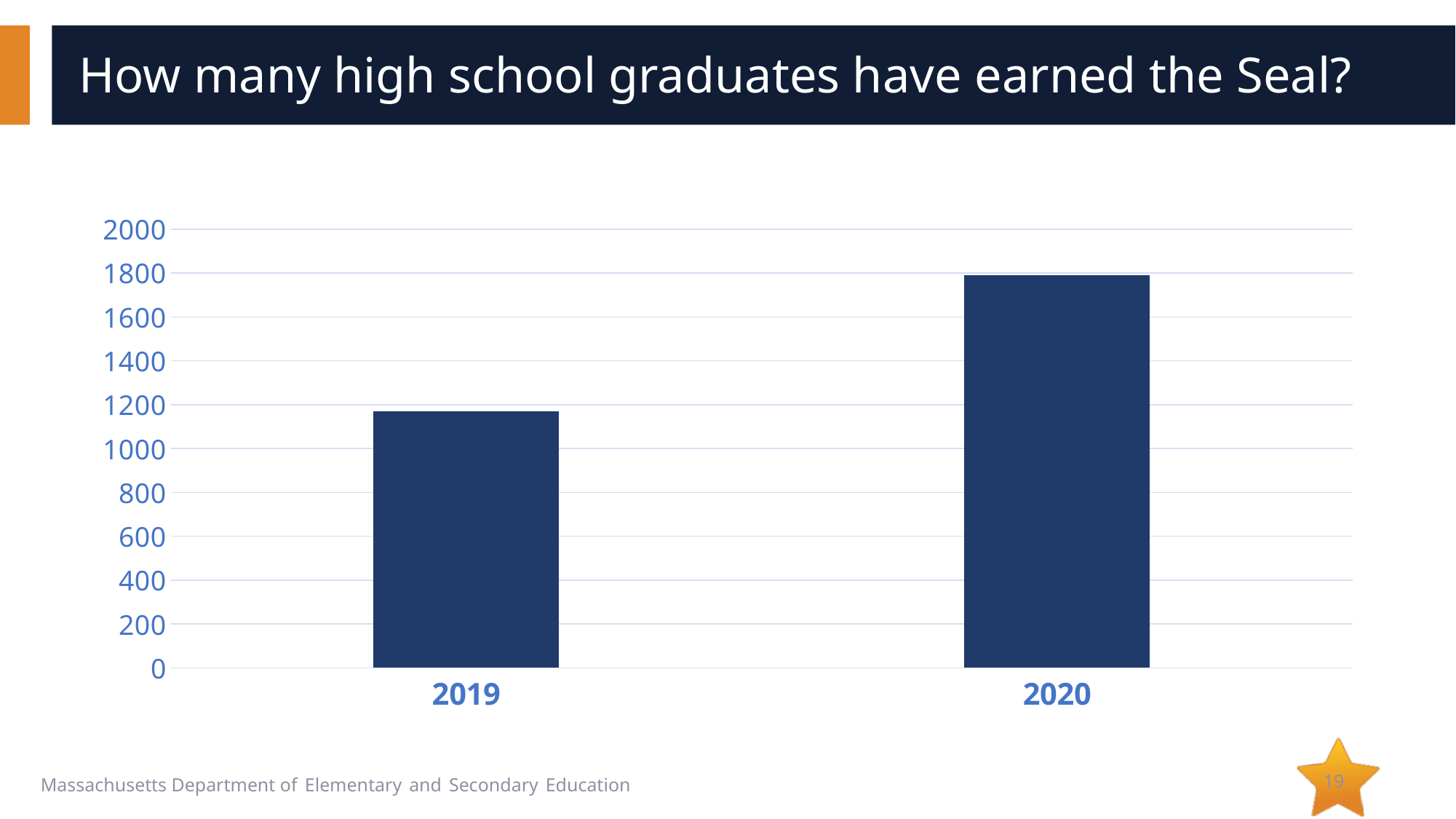
What kind of chart is shown on the slide? bar chart Which year has the lower bar? 2019 What is the highest value shown on the y axis? 2000 Is the value for 2019 greater or less than 1000? greater Is the value for 2020 greater or less than 1600? greater Is the value for 2020 greater or less than 2000? less Which year has the higher bar? 2020 How many categories are plotted on the x axis? 2 What is the title of the slide containing the chart? How many high school graduates have earned the Seal? Is the value for 2020 larger or smaller than the value for 2019? larger Do the values rise or fall from 2019 to 2020? rise